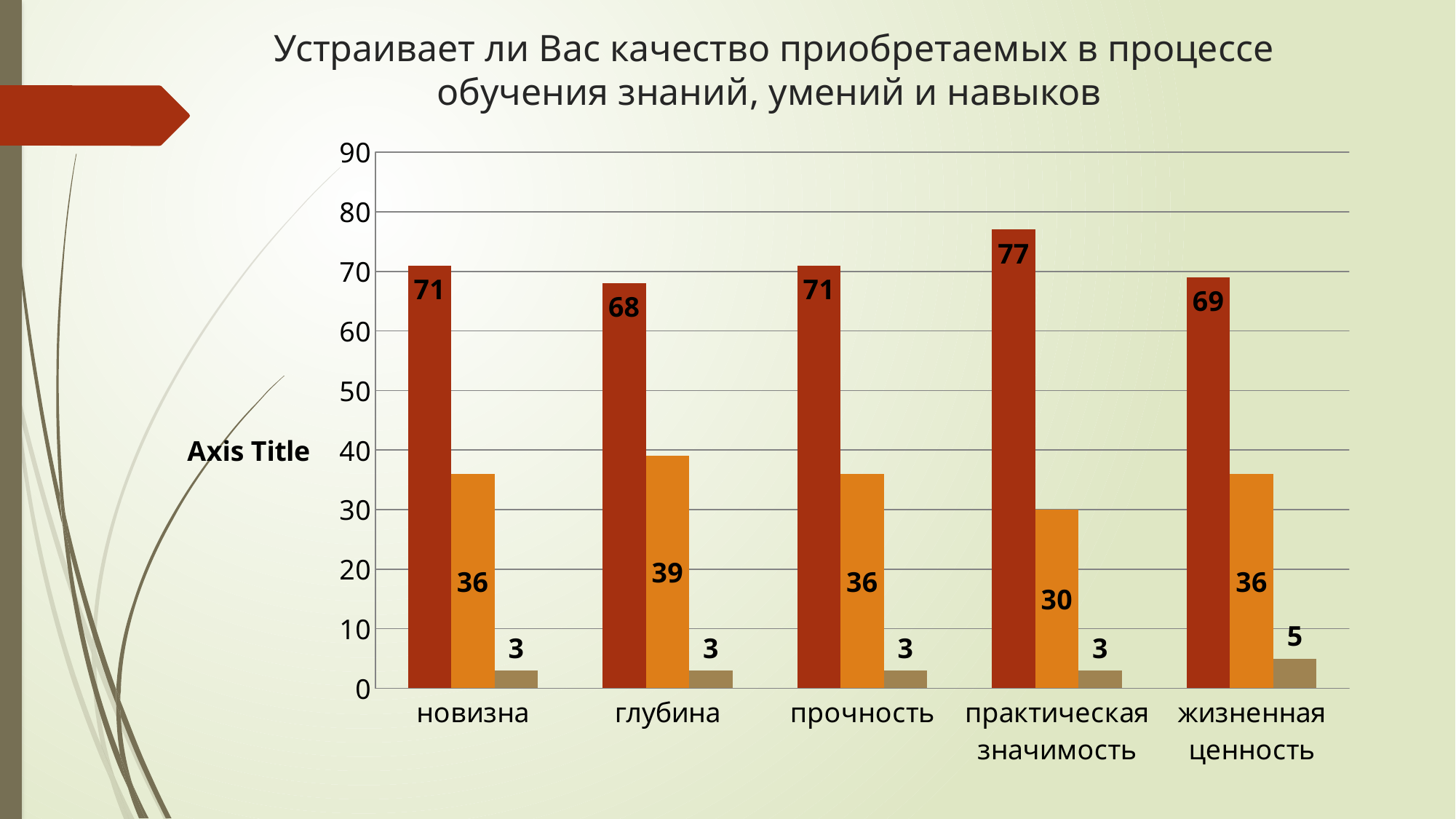
Which is larger: the dark red bar for глубина or the dark red bar for жизненная ценность? жизненная ценность How many bars are shown for each category? 3 Which category has the highest dark red bar? практическая значимость What kind of chart is shown on the slide? bar chart What is the label shown on the vertical axis? Axis Title What is the value of the dark red bar for практическая значимость? 77 How many categories are shown on the x axis? 5 What is the value of the brown bar for жизненная ценность? 5 What is the value of the orange bar for глубина? 39 Which category has the lowest orange bar? практическая значимость Is the orange bar for практическая значимость greater or less than 40? less What is the difference between the dark red bar and the orange bar for новизна? 35